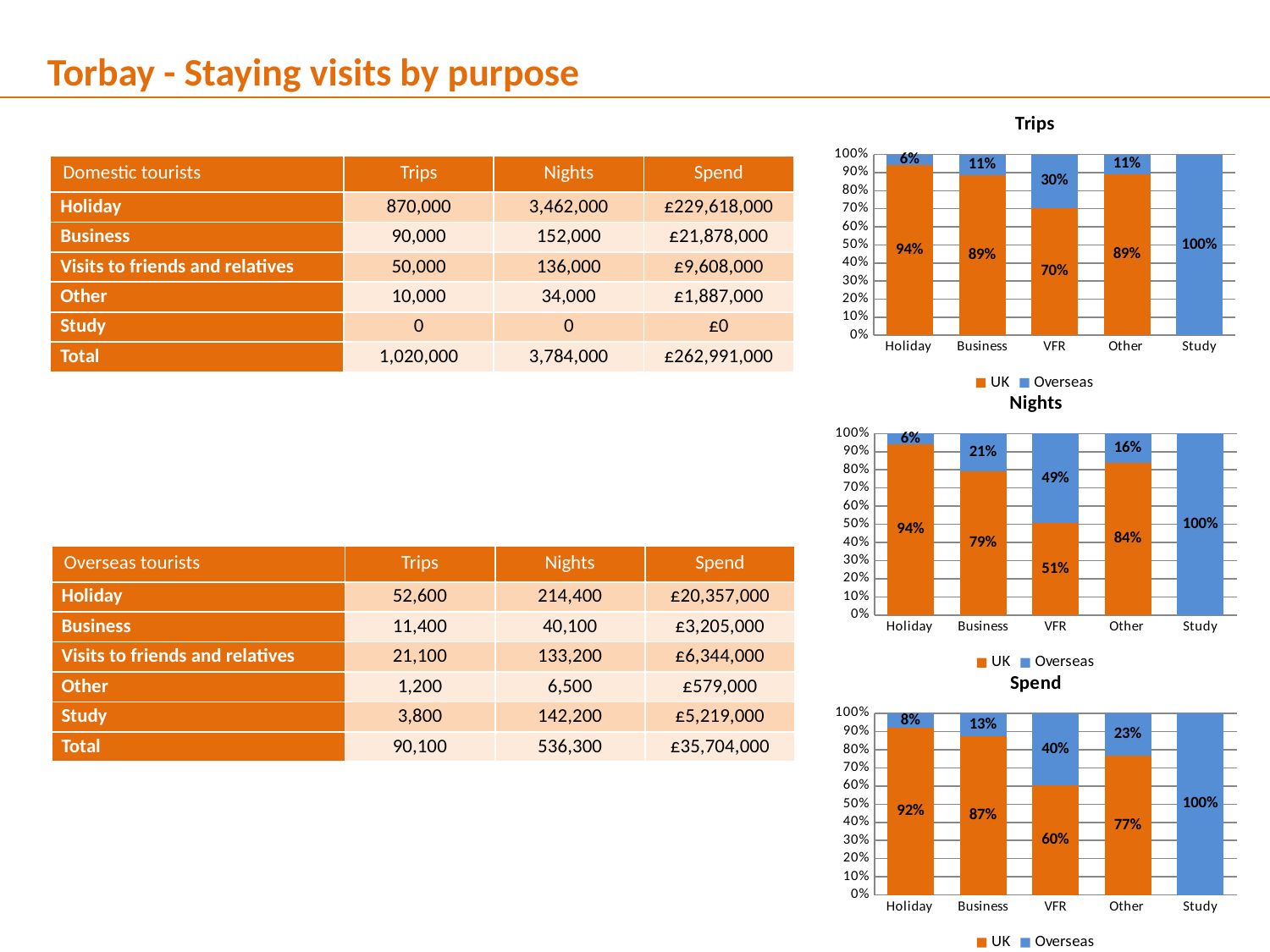
What type of chart is the Trips chart? Stacked bar chart In the Nights chart, which category has the highest Overseas share? Study In the Trips chart, what is the UK share for VFR? 70% How many categories are shown on the x axis of the Nights chart? 5 In the Nights chart, what is the UK share for Other? 84% In the Trips chart, is the Overseas share for VFR larger or smaller than the Overseas share for Other? larger In the Nights chart, what is the Overseas share for VFR? 49% In the Trips chart, what is the Overseas share for Business? 11% How many series does the legend of the Spend chart list? 2 In the Spend chart, which category has the lowest UK share among those with a UK segment? VFR In the Spend chart, what is the Overseas share for Other? 23% In the Spend chart, what is the difference between the UK share for Holiday and the UK share for VFR? 32%